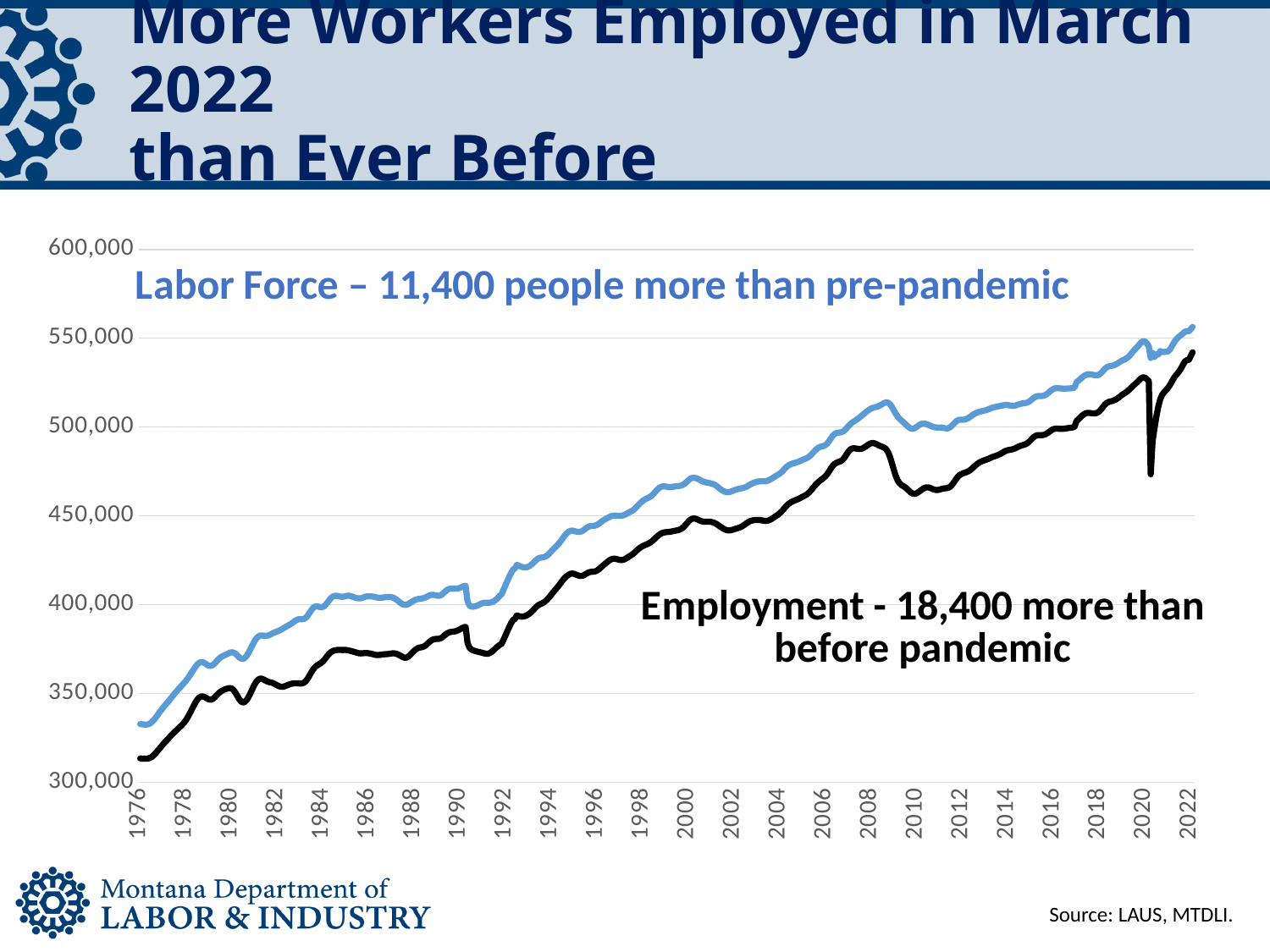
How many data series are plotted on the chart? 2 Overall, does the Employment line rise or fall from 1976 to 2022? rise Is the Employment value in 2022 greater or less than 550,000? less Is the Employment value in 1976 greater or less than 350,000? less Which two series are plotted on the chart? Labor Force and Employment Which series is higher in 2022, Labor Force or Employment? Labor Force According to the annotation on the chart, how many more people are in the labor force than pre-pandemic? 11,400 Is the Labor Force value in 2008 greater or less than 500,000? greater According to the annotation on the chart, how many more people are employed than before the pandemic? 18,400 What kind of chart is shown on the slide? line chart